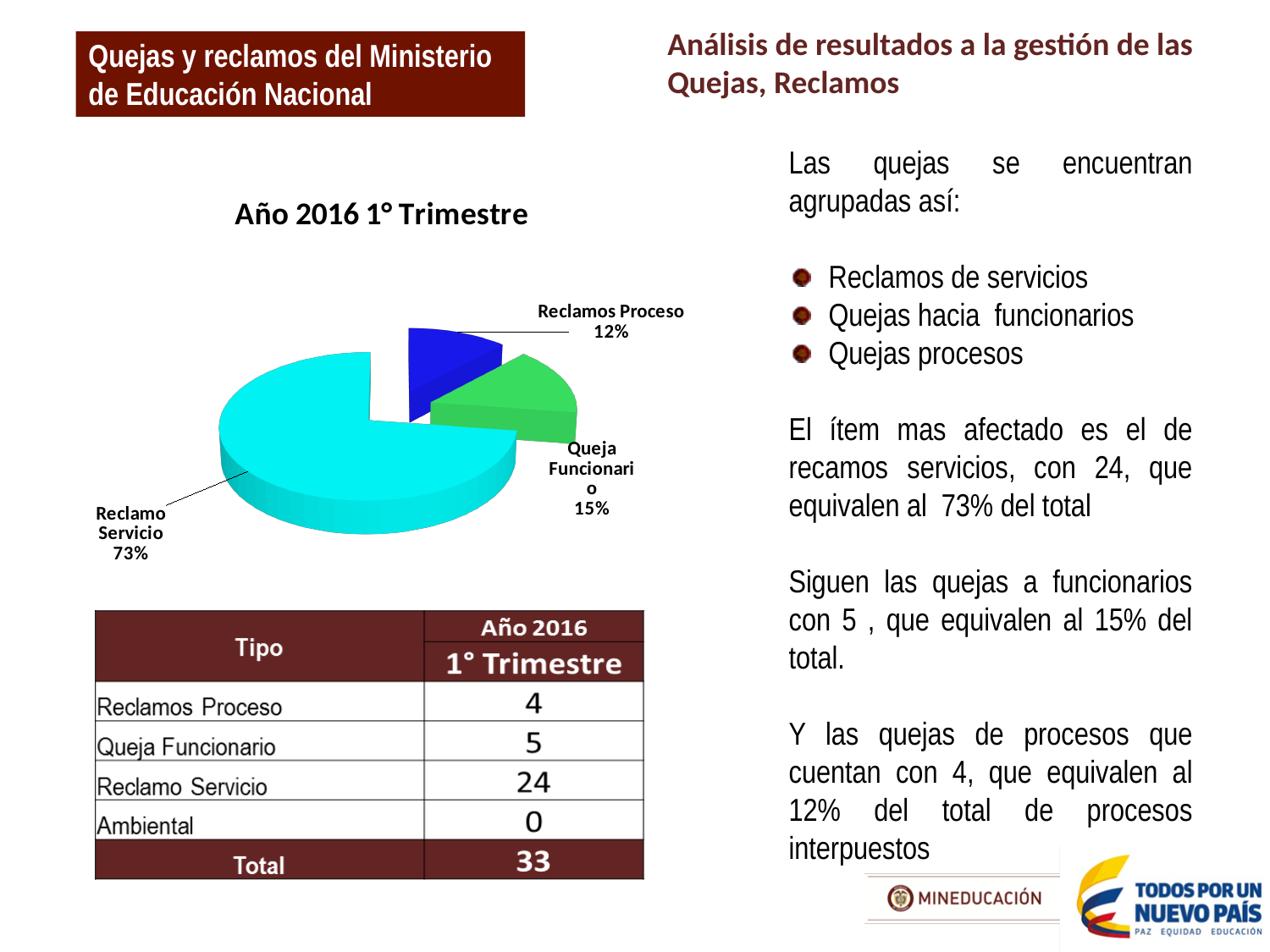
What share of the pie does Reclamo Servicio represent? 73% Which slice of the pie chart is the largest? Reclamo Servicio How many slices does the pie chart have? 3 What is the difference in percentage points between Queja Funcionario and Reclamos Proceso? 3 Which slice of the pie chart is the smallest? Reclamos Proceso Which is larger in the pie chart, Queja Funcionario or Reclamos Proceso? Queja Funcionario What colour is the Reclamo Servicio slice in the pie chart? Cyan What kind of chart is shown on the slide? Pie chart What share of the pie does Queja Funcionario represent? 15% What share of the pie does Reclamos Proceso represent? 12% What is the difference in percentage points between Reclamo Servicio and Queja Funcionario? 58 What is the title of the pie chart? Año 2016 1° Trimestre